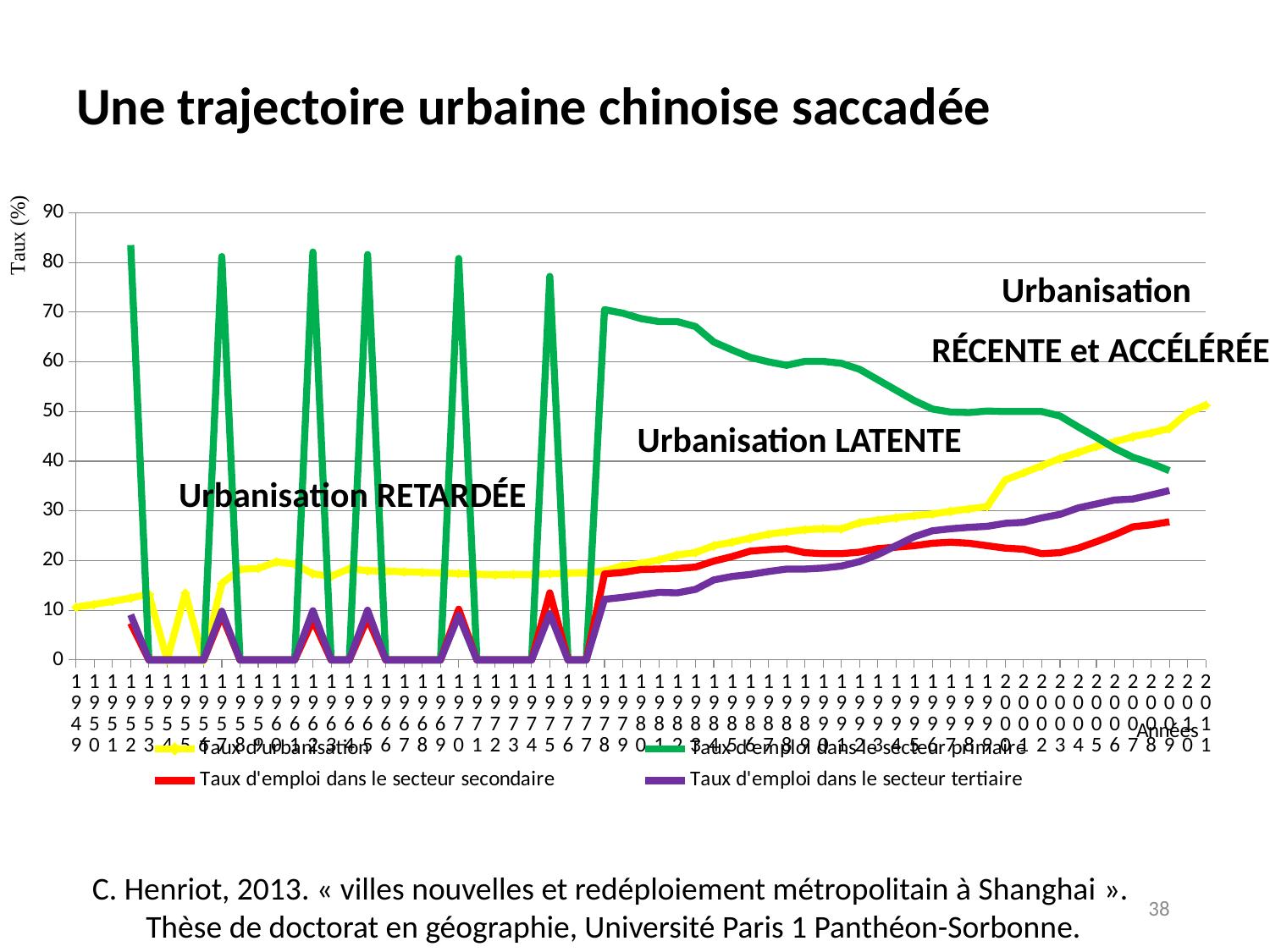
What is the label of the vertical axis? Taux (%) How many series does the legend list? 4 What kind of chart is shown on the slide? line chart Does the Taux d'urbanisation series rise or fall overall from 1949 to 2011? rise Which series reaches the highest value anywhere on the chart? Taux d'emploi dans le secteur primaire Which series are listed in the legend? Taux d'urbanisation, Taux d'emploi dans le secteur primaire, Taux d'emploi dans le secteur secondaire, Taux d'emploi dans le secteur tertiaire Is the value of Taux d'urbanisation in 2011 greater or less than 40? greater